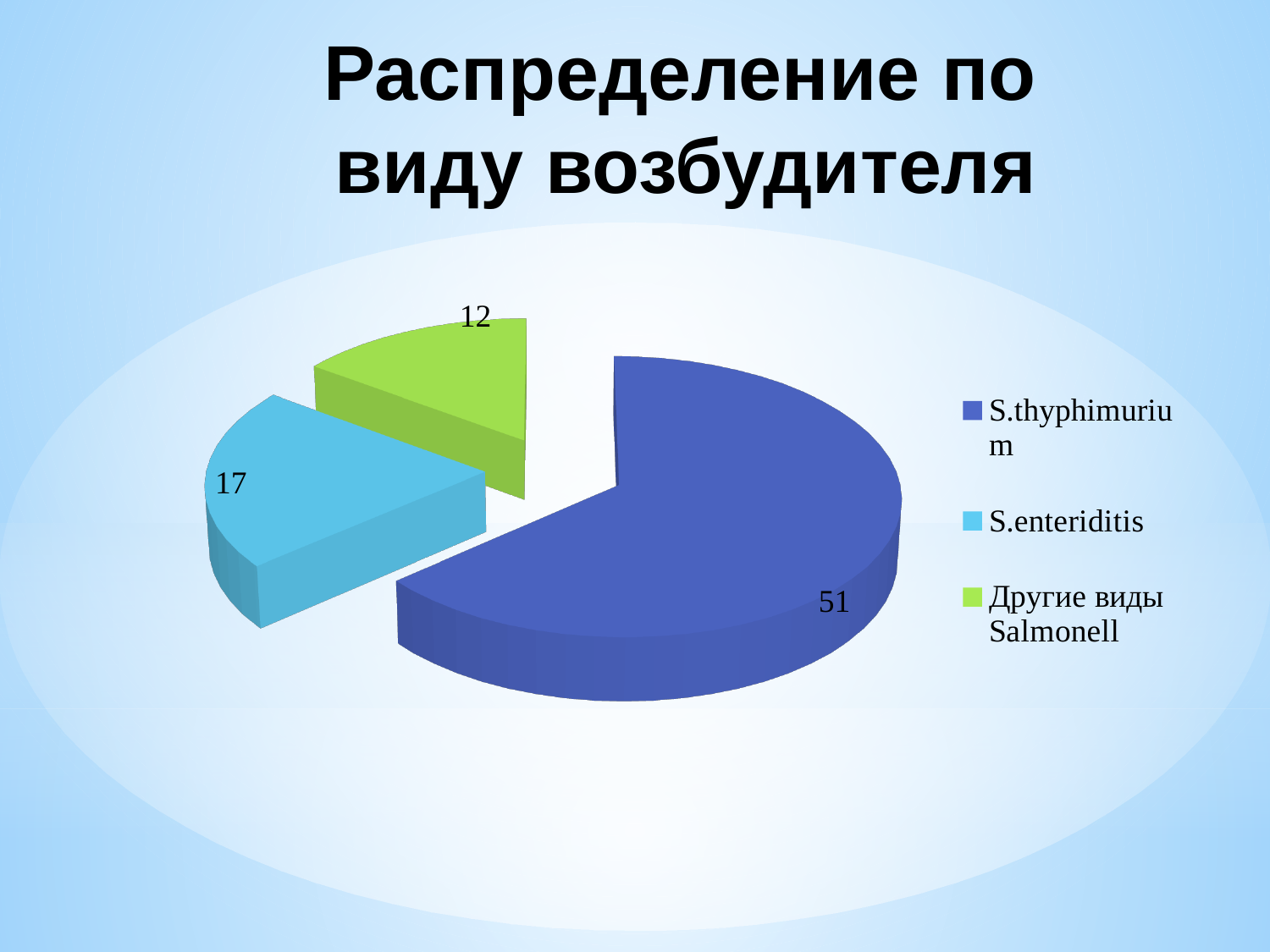
Which category has the smallest slice of the pie? Другие виды Salmonell What value is shown for Другие виды Salmonell? 12 What is the difference between the values for S.enteriditis and Другие виды Salmonell? 5 What kind of chart is shown on the slide? Pie chart Which is larger, the value for S.enteriditis or the value for Другие виды Salmonell? S.enteriditis What is the title of the chart on the slide? Распределение по виду возбудителя What value is shown for S.enteriditis? 17 How many slices does the pie chart have? 3 What is the difference between the values for S.thyphimurium and S.enteriditis? 34 Which category has the largest slice of the pie? S.thyphimurium What share of the pie does Другие виды Salmonell represent? 15% What value is shown for S.thyphimurium? 51